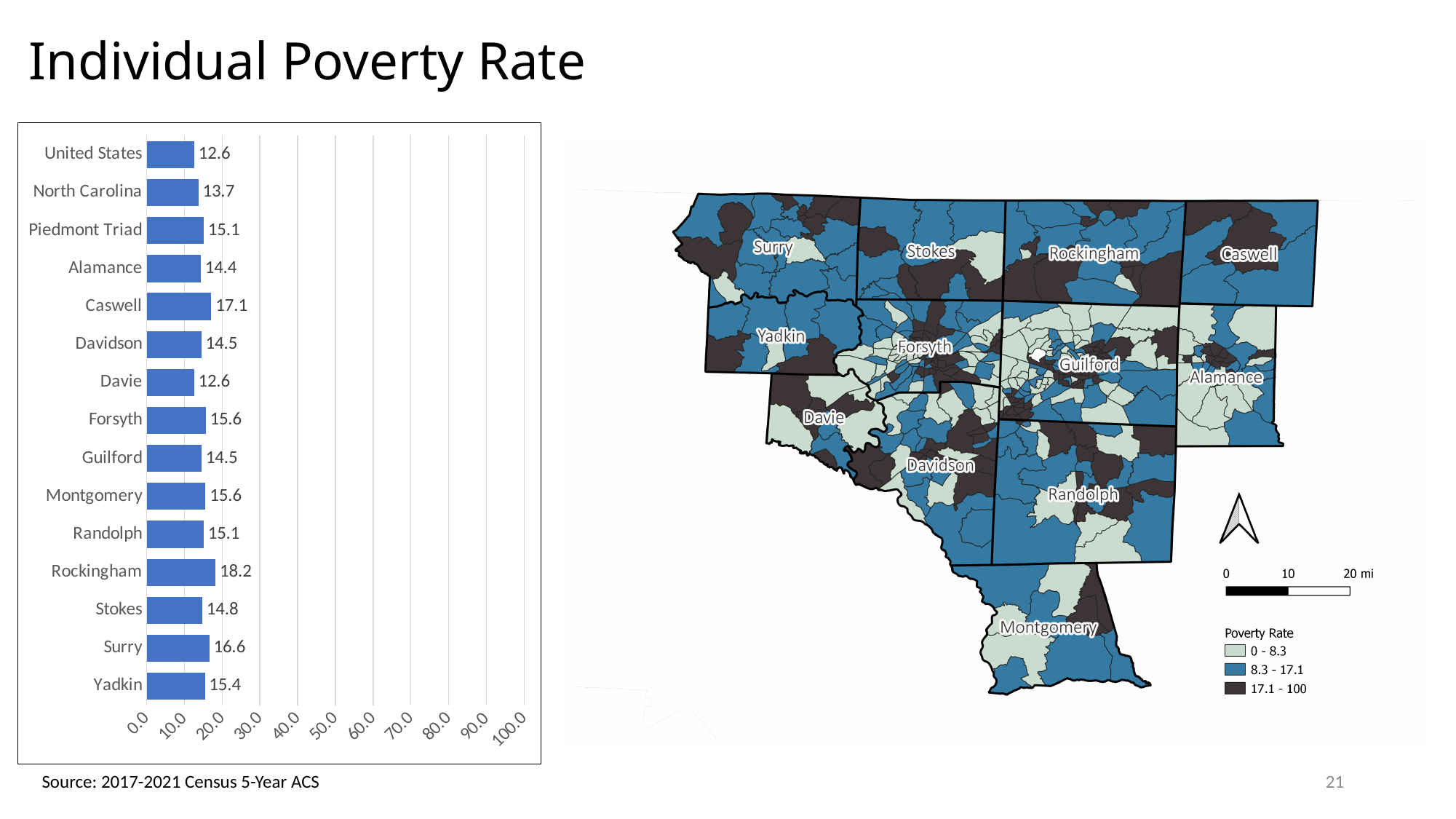
What is the individual poverty rate shown for Surry? 16.6 What is the difference between the poverty rates of Rockingham and Caswell? 1.1 How many categories are shown in the bar chart? 15 What is the individual poverty rate shown for North Carolina? 13.7 What is the individual poverty rate shown for the Piedmont Triad? 15.1 Is the value for Rockingham greater or less than 20.0? less What is the difference between the poverty rates of Surry and Davie? 4.0 Which category has the highest individual poverty rate in the bar chart? Rockingham Which has a higher individual poverty rate, Surry or Yadkin? Surry What kind of chart is used to show the individual poverty rates on the left of the slide? Bar chart What is the individual poverty rate shown for Rockingham? 18.2 Which has a higher individual poverty rate, Caswell or Alamance? Caswell